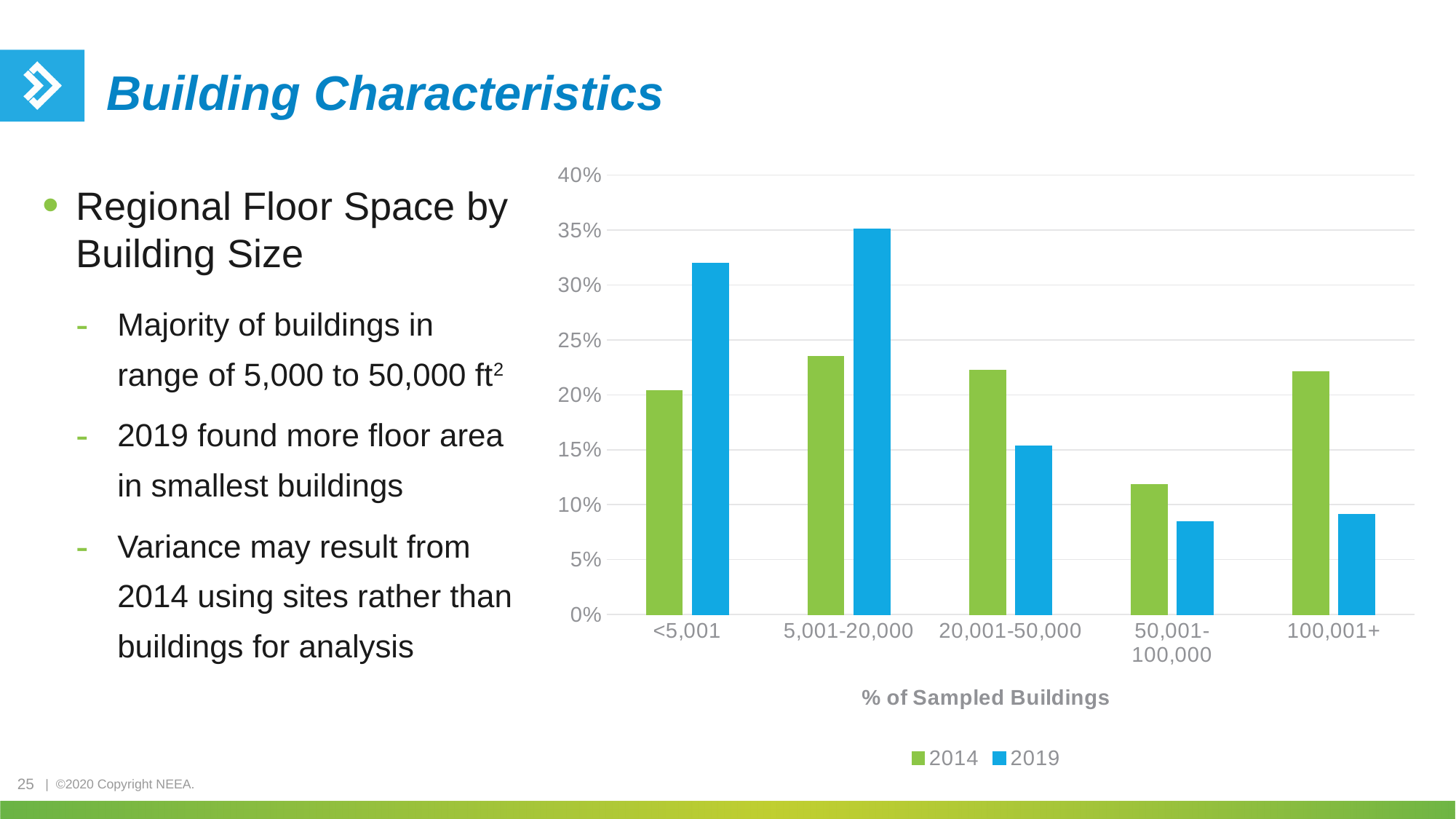
What is the axis title shown below the category labels? % of Sampled Buildings For the <5,001 category, which series is larger, 2014 or 2019? 2019 Do the 2019 values rise or fall from the 5,001-20,000 category to the 50,001-100,000 category? fall Which building size category has the lowest value for 2014? 50,001-100,000 For the 100,001+ category, which series is larger, 2014 or 2019? 2014 Is the 2019 value for <5,001 greater or less than 30%? greater Is the 2014 value for 20,001-50,000 greater or less than 25%? less How many building size categories are shown on the x axis? 5 What kind of chart is shown on the slide? bar chart Is the 2019 value for 50,001-100,000 greater or less than 10%? less How many series does the legend list? 2 Which building size category has the highest value for 2019? 5,001-20,000